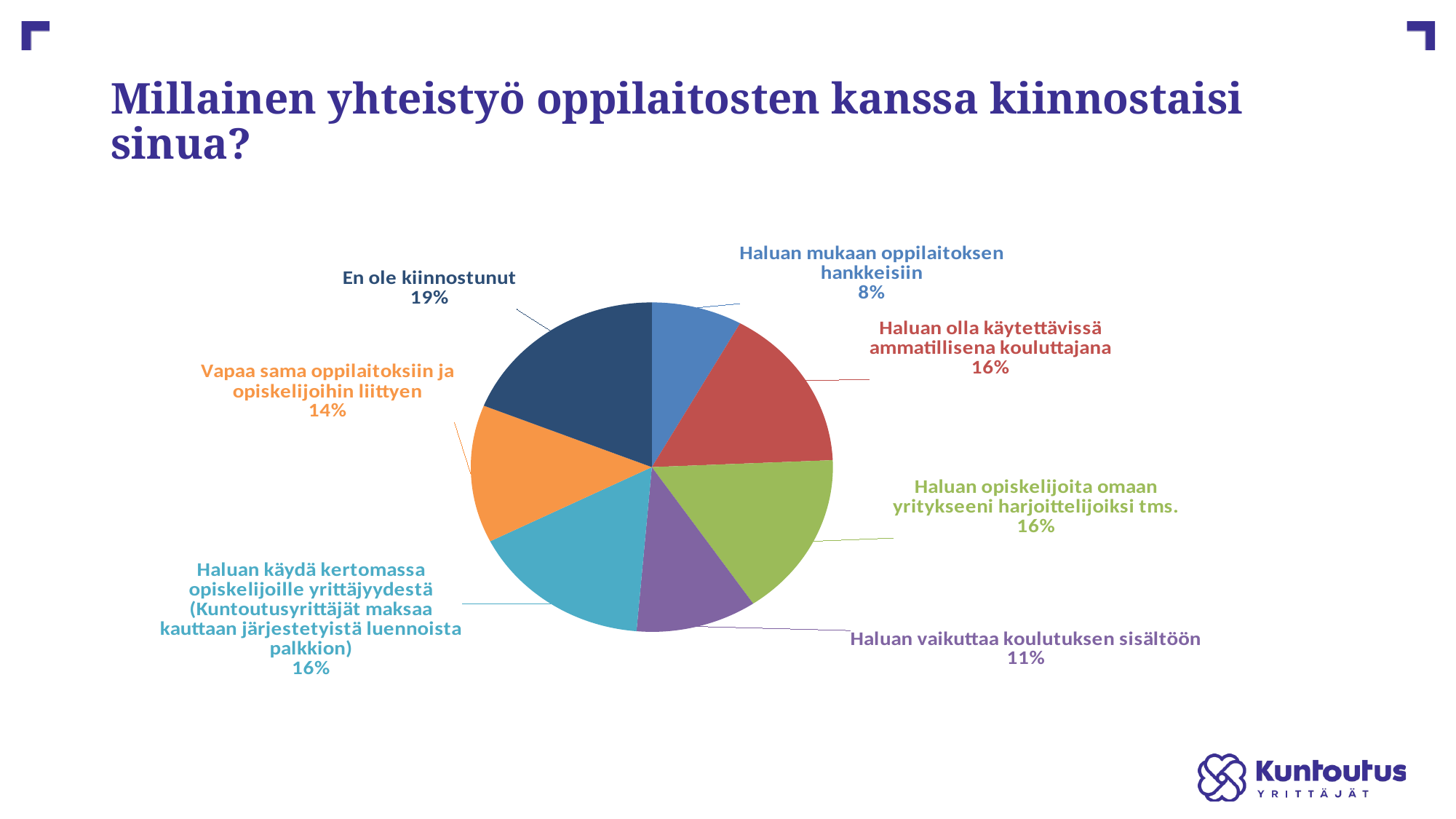
What is the difference in percentage points between "En ole kiinnostunut" and "Haluan mukaan oppilaitoksen hankkeisiin"? 11 percentage points Which category has the smallest share of the pie? Haluan mukaan oppilaitoksen hankkeisiin Which category has the largest share of the pie? En ole kiinnostunut What type of chart is shown on the slide? Pie chart What is the value for "Haluan vaikuttaa koulutuksen sisältöön"? 11% What is the value for "Haluan mukaan oppilaitoksen hankkeisiin"? 8% What share of the pie does "En ole kiinnostunut" represent? 19% Which is larger: "En ole kiinnostunut" or "Vapaa sama oppilaitoksiin ja opiskelijoihin liittyen"? En ole kiinnostunut How many categories (slices) does the pie chart have? 7 What is the value for "Haluan olla käytettävissä ammatillisena kouluttajana"? 16% What is the value for "Vapaa sama oppilaitoksiin ja opiskelijoihin liittyen"? 14% What is the title of the slide containing the pie chart? Millainen yhteistyö oppilaitosten kanssa kiinnostaisi sinua?